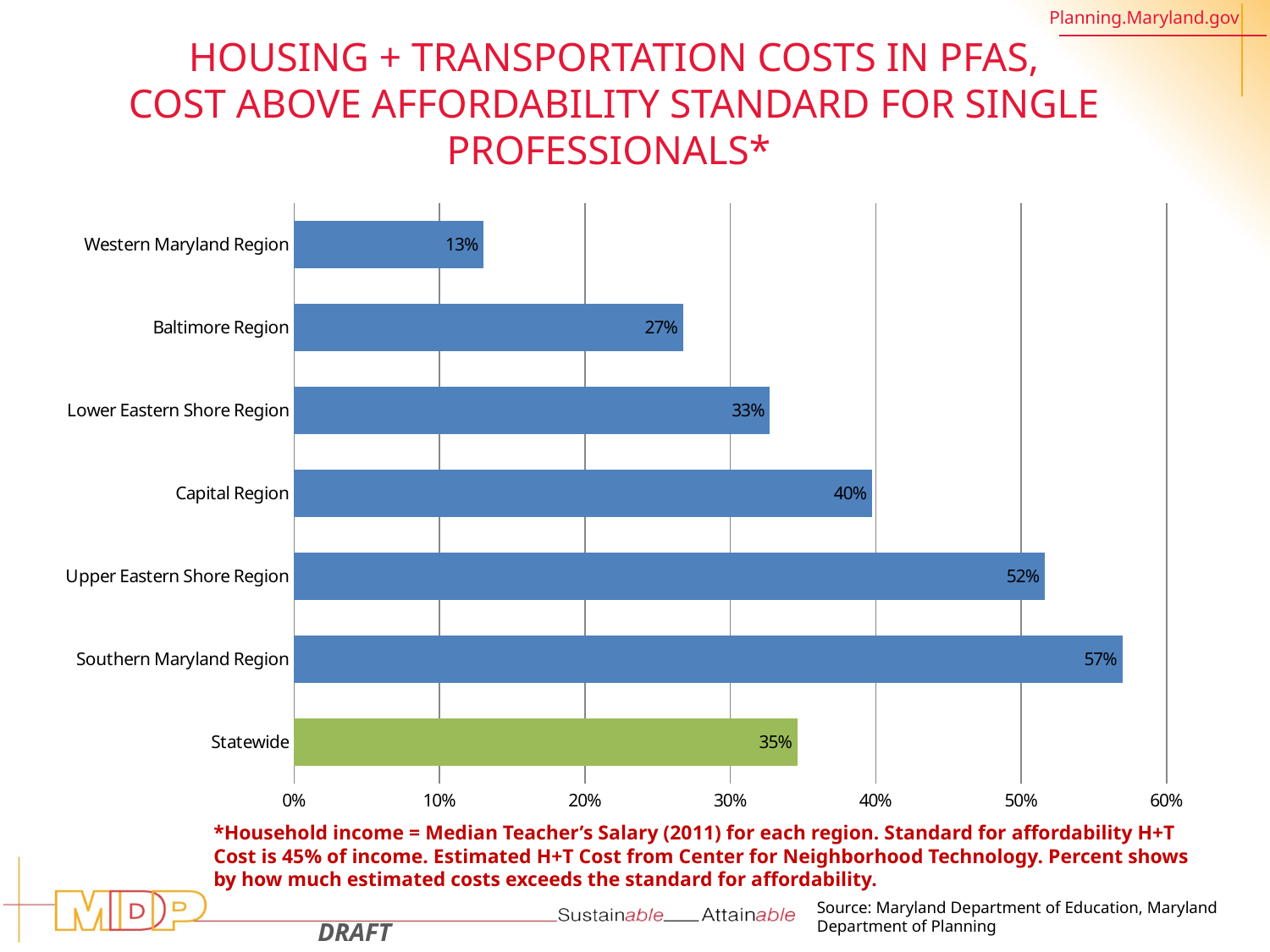
What is the Statewide value? 35% What kind of chart is shown on the slide? Bar chart Which region has the highest value? Southern Maryland Region What is the difference between the Upper Eastern Shore Region and the Lower Eastern Shore Region values? 19% What is the value for the Western Maryland Region? 13% What is the difference between the Southern Maryland Region and the Baltimore Region values? 30% What is the value for the Capital Region? 40% Which bar is shown in a different colour (green) from the others? Statewide How many categories (bars) are shown in the chart? 7 Is the value for the Upper Eastern Shore Region greater or less than 50%? greater Which region has the lowest value? Western Maryland Region Which is larger, the value for the Baltimore Region or the value for the Lower Eastern Shore Region? Lower Eastern Shore Region